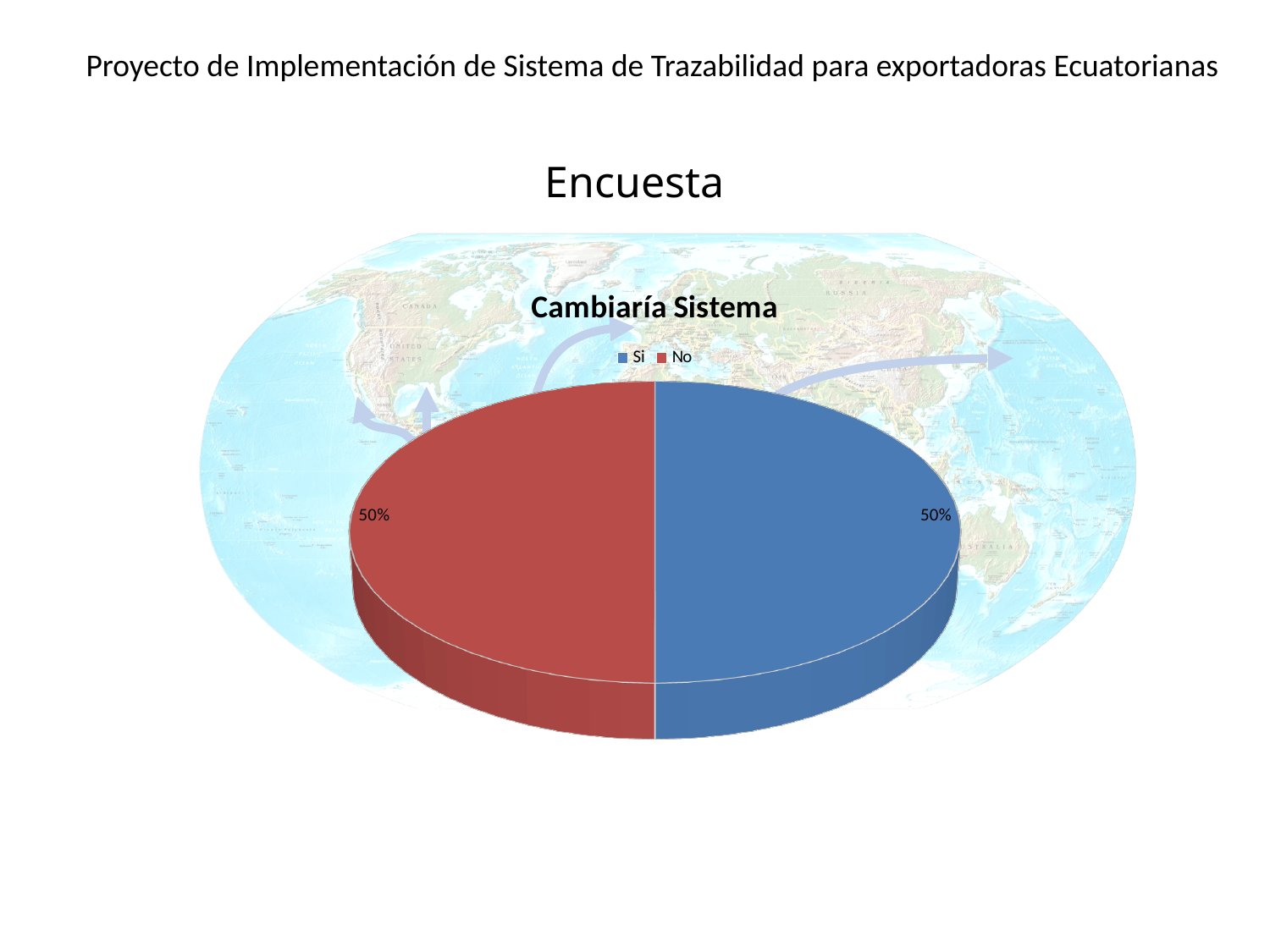
Which colour represents 'No' in the chart? red What kind of chart is shown on the slide? pie chart What is the title of the chart? Cambiaría Sistema What is the difference between the 'Si' and 'No' shares? 0% How many slices does the pie chart have? 2 How many series does the legend list? 2 What share of the pie is the 'Si' slice? 50% What is the combined share of the 'Si' and 'No' slices? 100% What share of the pie is the 'No' slice? 50%